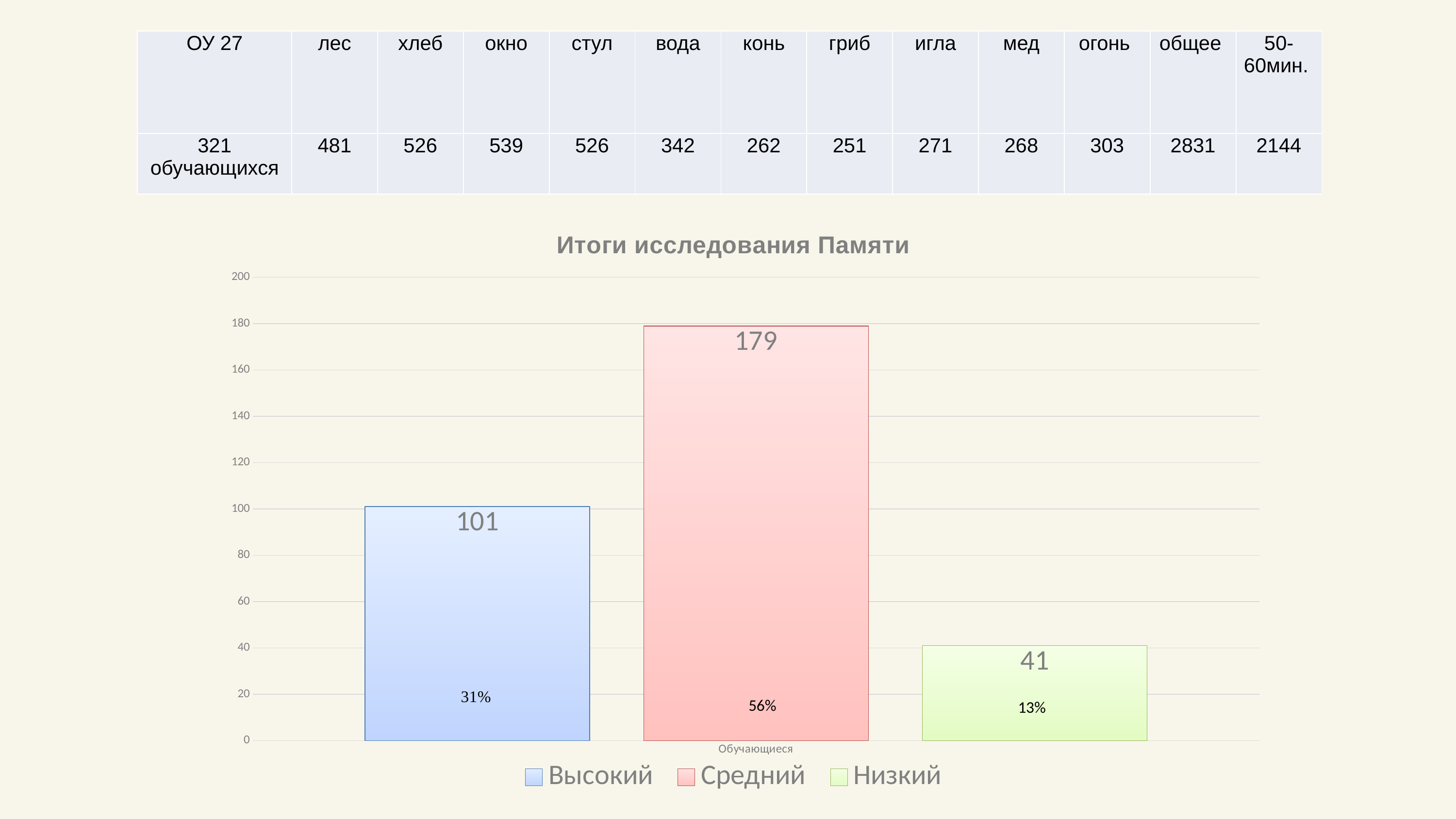
What is the difference between the Высокий and Низкий values? 60 What kind of chart is shown on the slide? bar chart Is the value for Средний greater or less than 160? greater Which is larger, the value for Высокий or the value for Низкий? Высокий Which series has the highest value in the chart? Средний What is the value for the Высокий series in the chart? 101 How many series does the legend list? 3 What percentage label is shown on the Средний bar? 56% Which series has the lowest value in the chart? Низкий What is the value for the Низкий series in the chart? 41 What is the difference between the Средний and Высокий values? 78 What is the value for the Средний series in the chart? 179